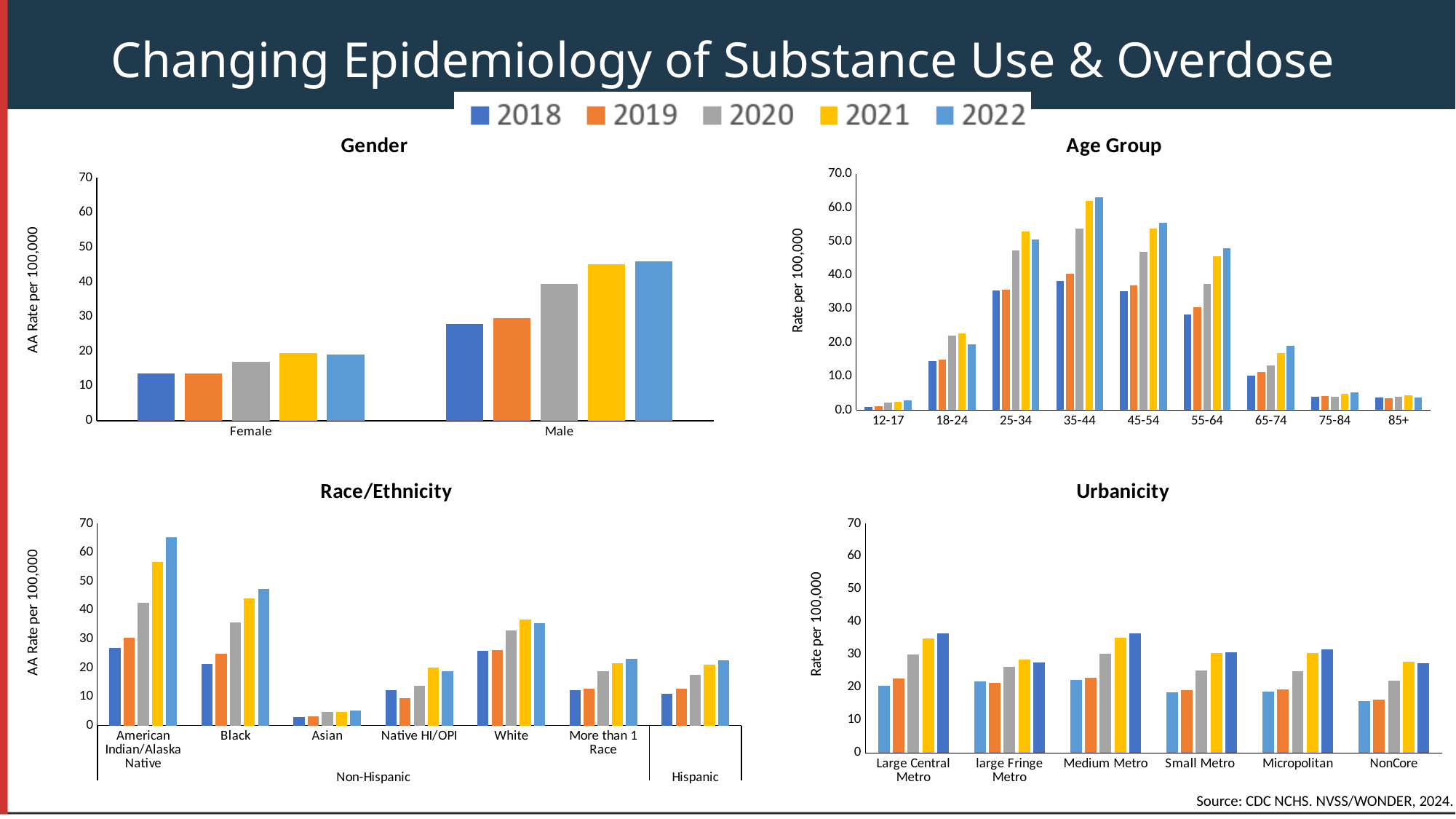
In the Age Group chart, which age group has the lowest 2022 value? 12-17 What kind of chart is the Gender chart? bar chart In the Gender chart, which is larger in 2021, Female or Male? Male How many age groups are shown on the x axis of the Age Group chart? 9 In the Age Group chart, which age group has the highest 2022 value? 35-44 How many series does the shared legend list? 5 In the Age Group chart, is the 2022 value for 35-44 greater or less than 60.0? greater In the Gender chart, is the 2022 value for Male greater or less than 40? greater In the Race/Ethnicity chart, is the 2022 value for Asian greater or less than 10? less In the Race/Ethnicity chart, which category has the highest 2022 value? American Indian/Alaska Native In the Urbanicity chart, do the values for Large Central Metro rise or fall from 2018 to 2022? rise